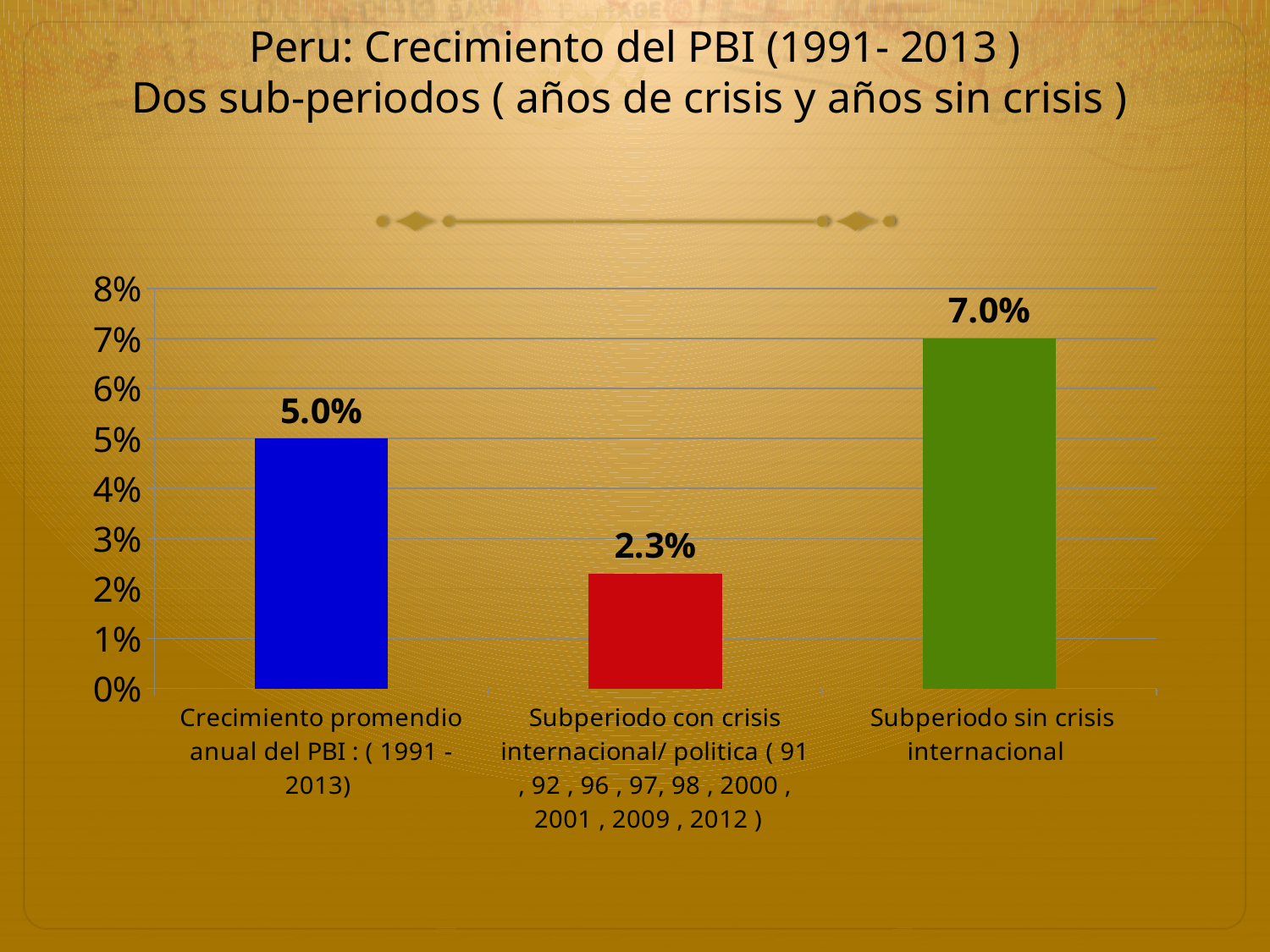
Is the value for 'Subperiodo con crisis internacional/ politica' greater or less than 3%? less What is the value for 'Subperiodo sin crisis internacional'? 7.0% Which category has the highest value? Subperiodo sin crisis internacional Which category has the lowest value? Subperiodo con crisis internacional/ politica Which is larger: the value for 'Crecimiento promendio anual del PBI' or the value for 'Subperiodo con crisis internacional/ politica'? Crecimiento promendio anual del PBI What is the value for 'Crecimiento promendio anual del PBI : ( 1991 - 2013)'? 5.0% What colour is the bar for 'Subperiodo sin crisis internacional'? green What is the difference between the value for 'Subperiodo sin crisis internacional' and the value for 'Subperiodo con crisis internacional/ politica'? 4.7% How many categories are shown in the chart? 3 What kind of chart is shown on the slide? bar chart What is the value for 'Subperiodo con crisis internacional/ politica'? 2.3% What is the difference between the value for 'Subperiodo sin crisis internacional' and the average annual growth for 1991-2013? 2.0%